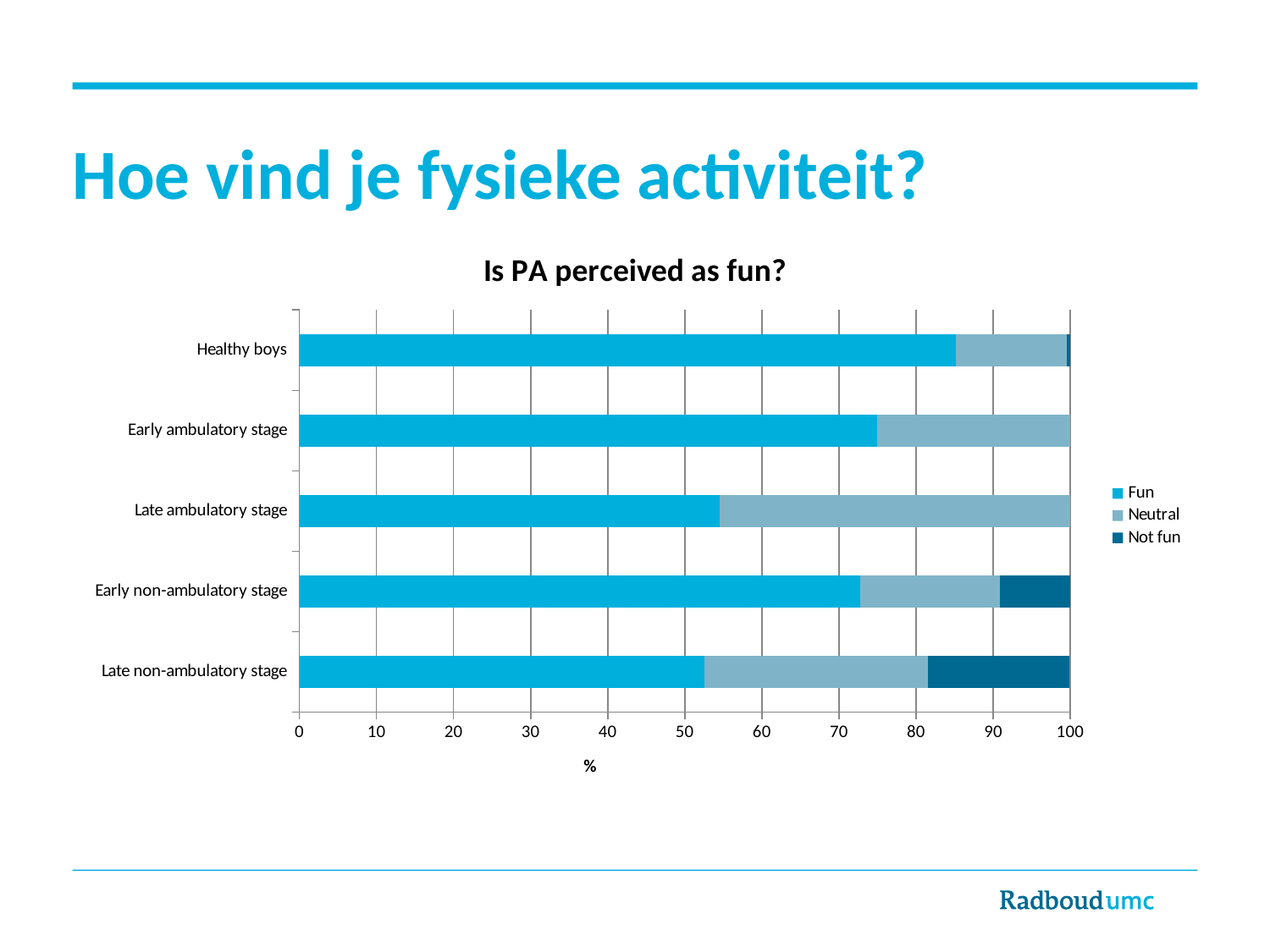
Which group has the larger Fun value, Healthy boys or Early ambulatory stage? Healthy boys Is the Fun value for Early non-ambulatory stage greater or less than 70? greater Is the Fun value for Late non-ambulatory stage greater or less than 60? less What kind of chart is shown on the slide? Stacked bar chart How many series does the chart legend list? 3 Which group has the highest Fun value? Healthy boys What is the title of the chart? Is PA perceived as fun? Which group has the largest Neutral segment? Late ambulatory stage Which group has the largest Not fun segment? Late non-ambulatory stage Is the Fun value for Healthy boys greater or less than 80? greater What is the label on the x axis of the chart? % How many categories (groups) are shown on the y axis of the chart? 5